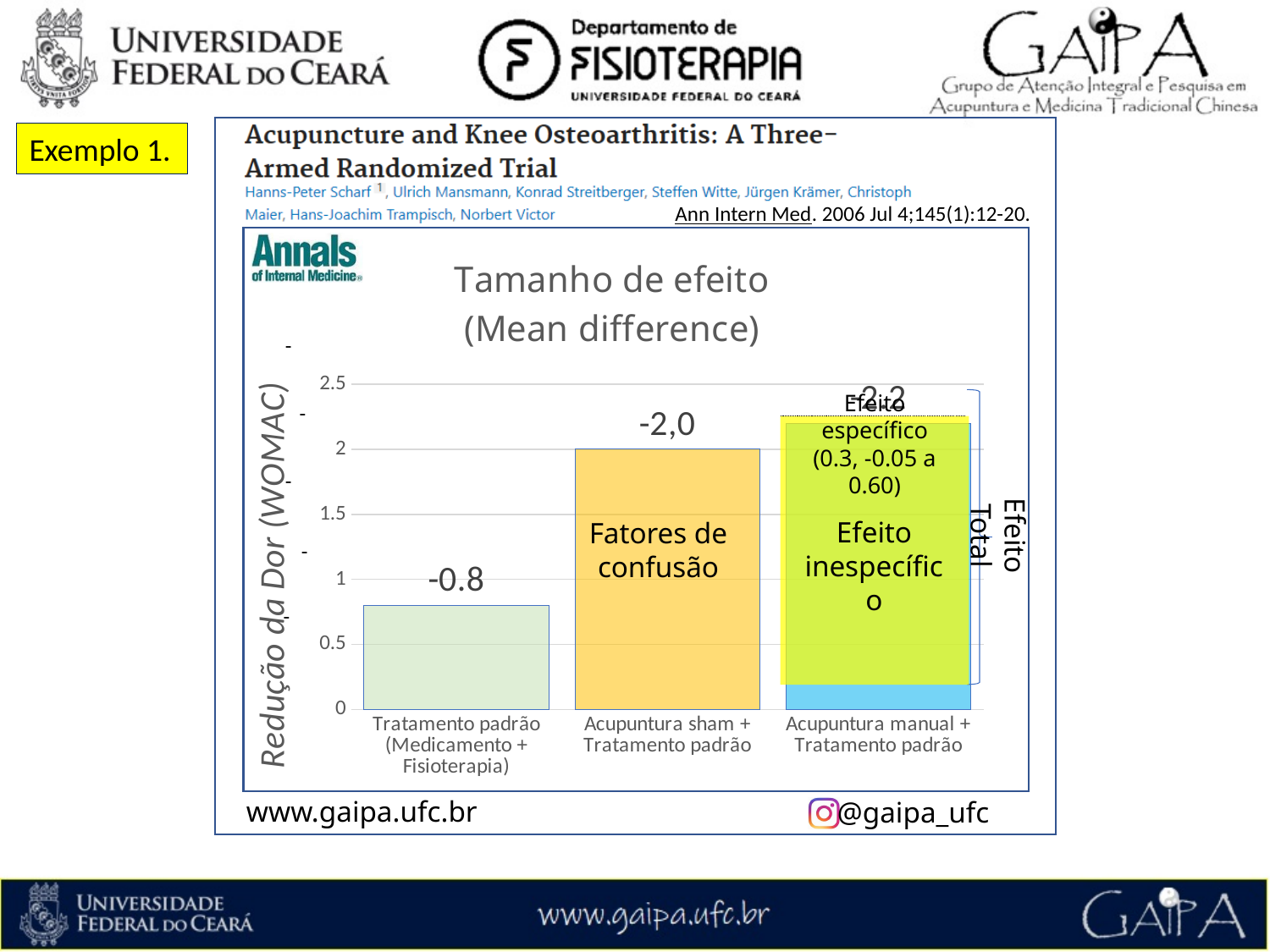
What is the value labelled on the bar for Tratamento padrão (Medicamento + Fisioterapia)? -0.8 What is the value labelled on the bar for Acupuntura sham + Tratamento padrão? -2,0 What is the title of the chart? Tamanho de efeito (Mean difference) Which category has the tallest bar? Acupuntura manual + Tratamento padrão Which category has the shortest bar? Tratamento padrão (Medicamento + Fisioterapia) How many categories (bars) are shown in the chart? 3 Is the bar for Acupuntura manual + Tratamento padrão greater or less than 2 on the y axis? greater What kind of chart is shown on the slide? bar chart What is the label of the vertical axis of the chart? Redução da Dor (WOMAC) Which bar is taller: Acupuntura sham + Tratamento padrão or Tratamento padrão (Medicamento + Fisioterapia)? Acupuntura sham + Tratamento padrão Do the bar heights rise or fall from left to right across the categories? rise Is the bar for Tratamento padrão (Medicamento + Fisioterapia) greater or less than 1 on the y axis? less